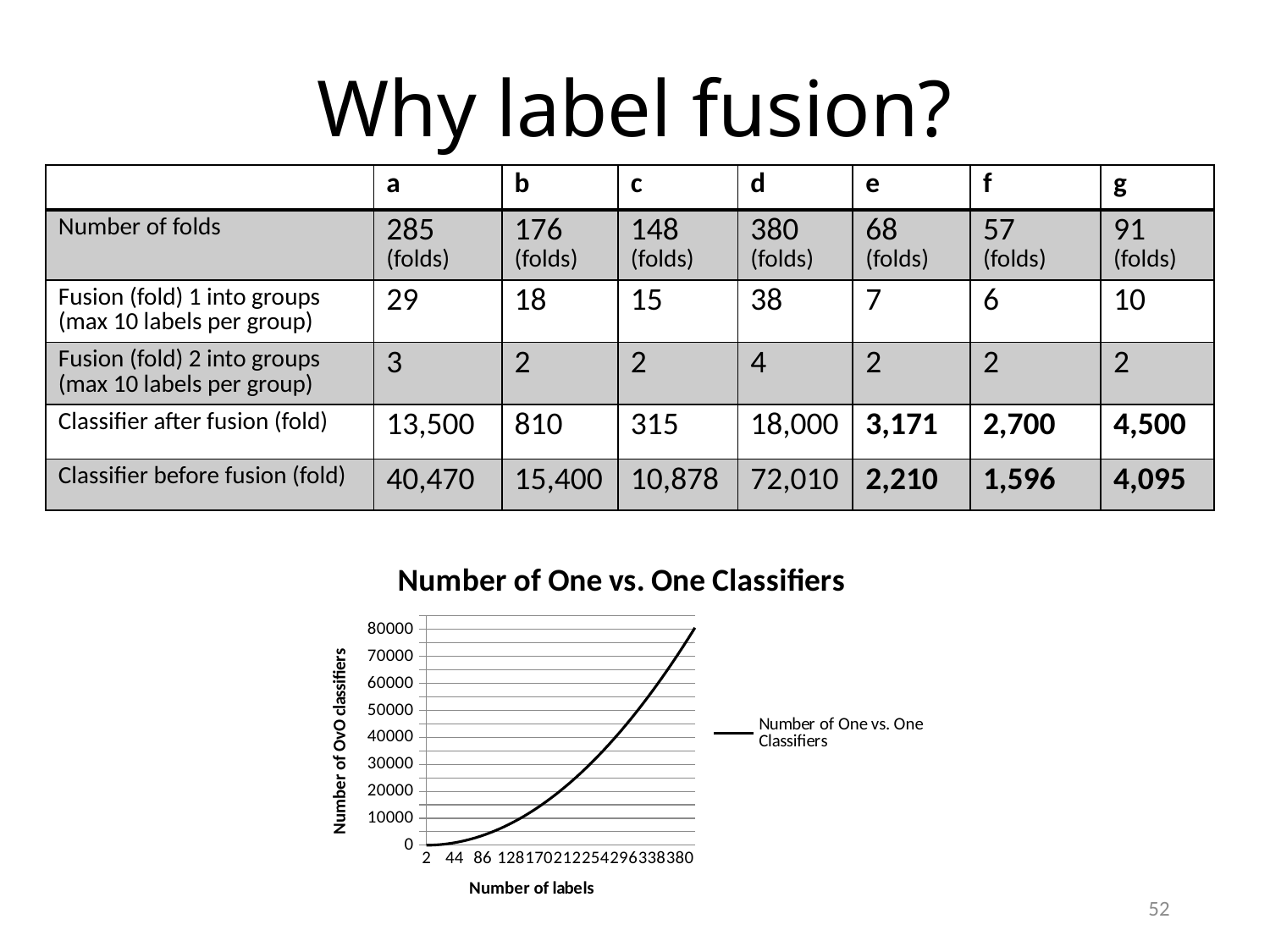
Is the number of OvO classifiers at 296 labels greater or less than 40000? greater At which number of labels on the x axis is the number of OvO classifiers lowest? 2 What is the title of the chart on the slide? Number of One vs. One Classifiers Is the number of OvO classifiers at 86 labels greater or less than 10000? less How many series does the chart's legend list? 1 Do the values in the chart rise or fall as the number of labels increases? rise How many tick labels are shown on the x axis of the chart? 10 What is the label of the x axis of the chart? Number of labels What kind of chart is shown on the slide? line chart Is the number of OvO classifiers at 170 labels greater or less than 20000? less